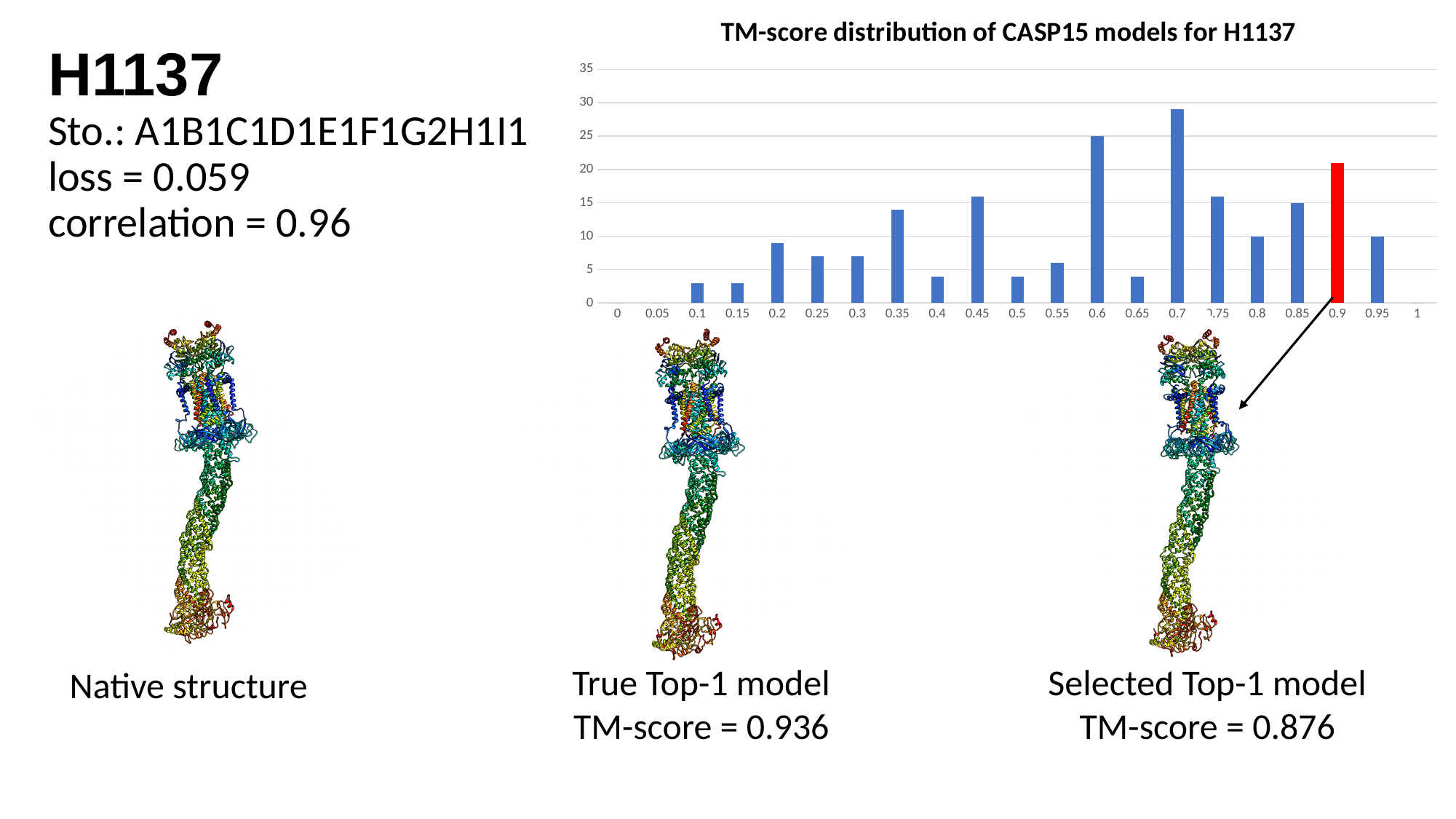
Is the value for the 0.65 bin greater or less than 5? less Is the value for the 0.35 bin greater or less than 10? greater What kind of chart is shown on the slide? bar chart Which TM-score bin has the highest bar? 0.7 Is the value for the 0.9 bin greater or less than 20? greater Which bin has the larger value, 0.8 or 0.85? 0.85 Which bin has the larger value, 0.6 or 0.9? 0.6 What is the title of the chart? TM-score distribution of CASP15 models for H1137 Which TM-score bin is drawn with a red bar? 0.9 How many bars are plotted in the chart? 18